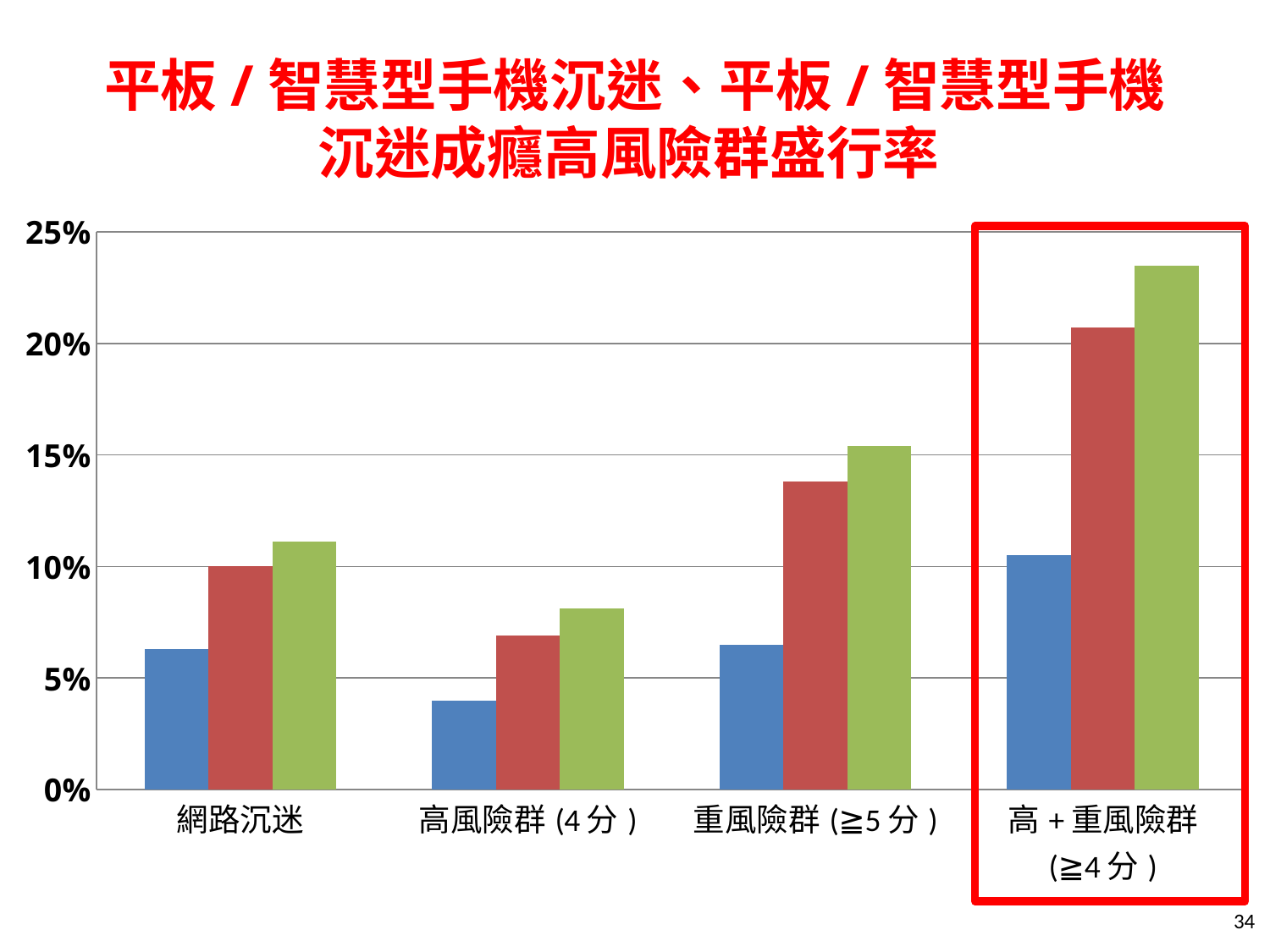
For 重風險群（≧5分）, which is larger, the green bar or the blue bar? the green bar How many categories are shown on the x axis of the chart? 4 Is the blue bar for 高風險群（4分） greater or less than 5%? less Which category has the shortest blue bar? 高風險群（4分） Is the red bar for 重風險群（≧5分） greater or less than 10%? greater What kind of chart is shown on the slide? bar chart Which category on the chart is highlighted with a red box? 高＋重風險群（≧4分） Which is larger, the red bar for 網路沉迷 or the red bar for 高風險群（4分）? the red bar for 網路沉迷 Is the green bar for 高＋重風險群（≧4分） greater or less than 20%? greater Which category has the tallest green bar? 高＋重風險群（≧4分） How many bars (series) are plotted for each category? 3